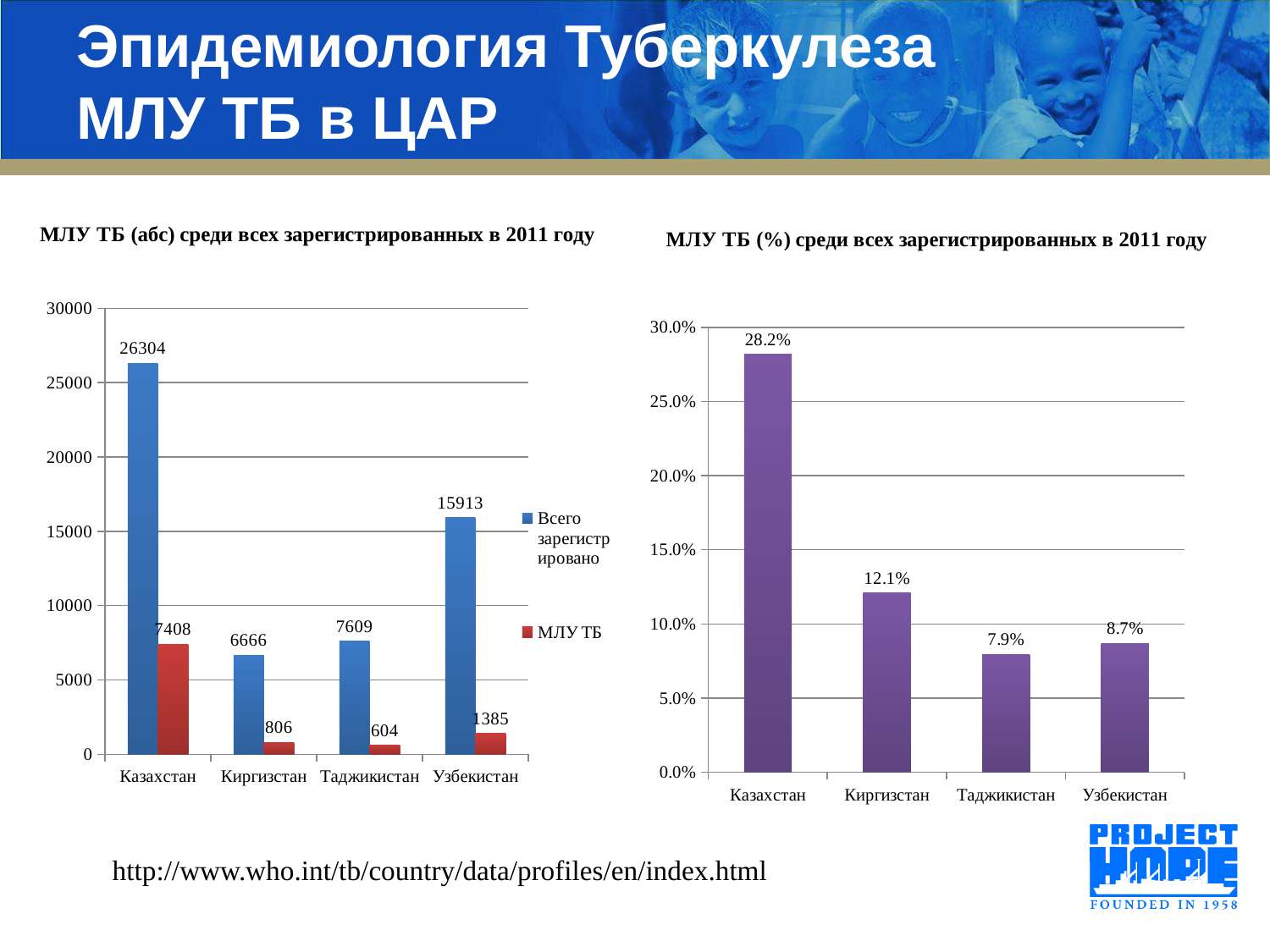
In the left chart (МЛУ ТБ (абс)), which is larger: Всего зарегистрировано for Киргизстан or for Таджикистан? Таджикистан In the left chart (МЛУ ТБ (абс)), what colour are the МЛУ ТБ bars? Red In the right chart (МЛУ ТБ (%)), what is the difference between Узбекистан and Таджикистан? 0.8% In the left chart (МЛУ ТБ (абс)), what is the value of МЛУ ТБ for Узбекистан? 1385 In the left chart (МЛУ ТБ (абс)), which country has the lowest МЛУ ТБ value? Таджикистан How many countries are shown on the x axis of the right chart (МЛУ ТБ (%))? 4 What type of chart is the right chart (МЛУ ТБ (%))? Bar chart How many series does the legend of the left chart (МЛУ ТБ (абс)) list? 2 In the right chart (МЛУ ТБ (%)), which country has the highest value? Казахстан In the right chart (МЛУ ТБ (%)), what is the value for Киргизстан? 12.1% In the left chart (МЛУ ТБ (абс)), what is the value of Всего зарегистрировано for Казахстан? 26304 In the left chart (МЛУ ТБ (абс)), what is the difference between Всего зарегистрировано and МЛУ ТБ for Казахстан? 18896